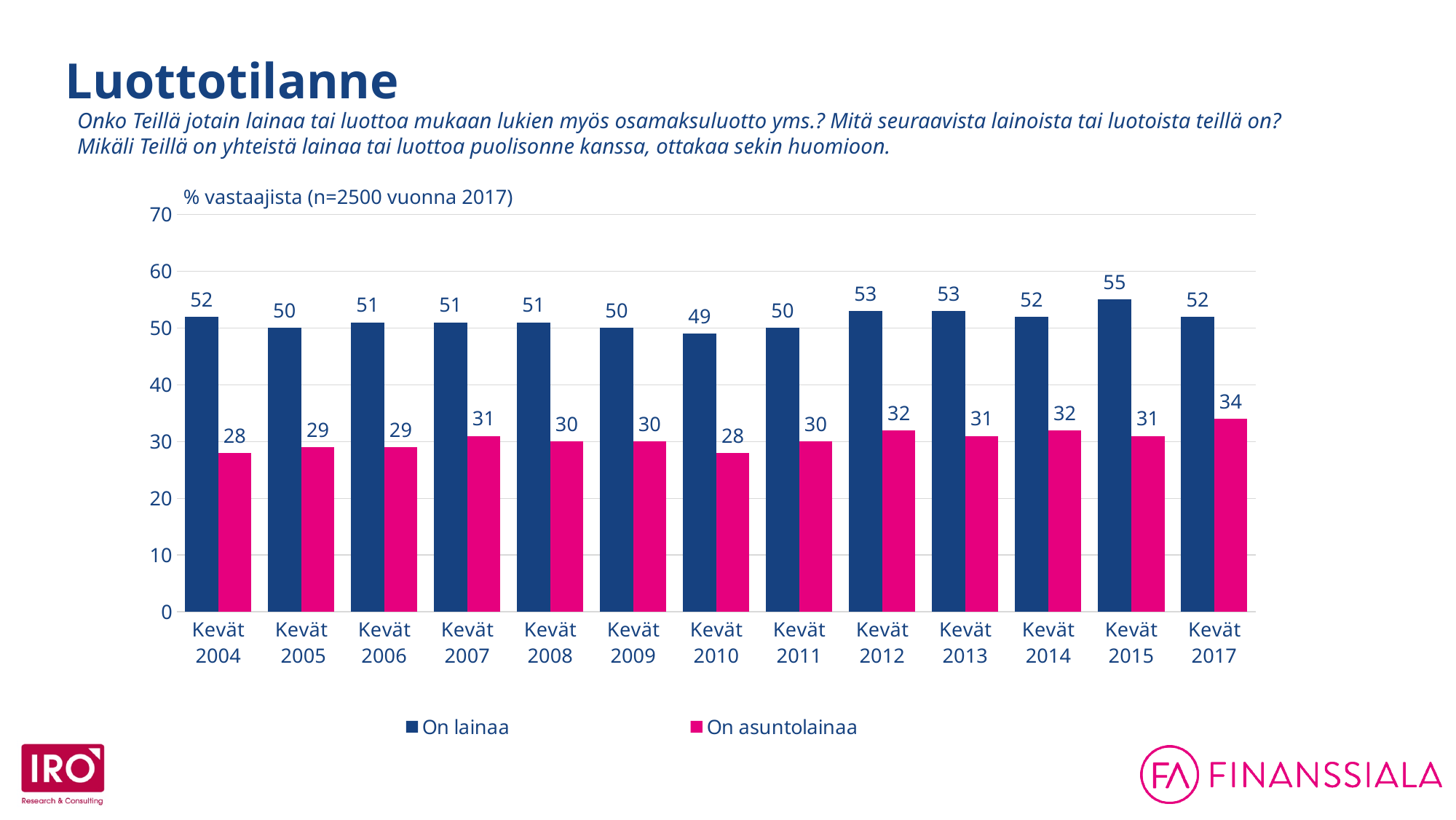
What is the value for "On lainaa" in Kevät 2010? 49 What colour are the "On asuntolainaa" bars? Pink (magenta) What is the value for "On lainaa" in Kevät 2015? 55 How many series does the legend list? 2 Which is larger: "On asuntolainaa" in Kevät 2004 or in Kevät 2017? Kevät 2017 How many years (categories) are shown on the x axis? 13 In which year is the "On asuntolainaa" value highest? Kevät 2017 What kind of chart is shown on the slide? Bar chart What is the value for "On asuntolainaa" in Kevät 2017? 34 In which year is the "On lainaa" value highest? Kevät 2015 In which year is the "On lainaa" value lowest? Kevät 2010 What is the difference between "On lainaa" and "On asuntolainaa" in Kevät 2017? 18